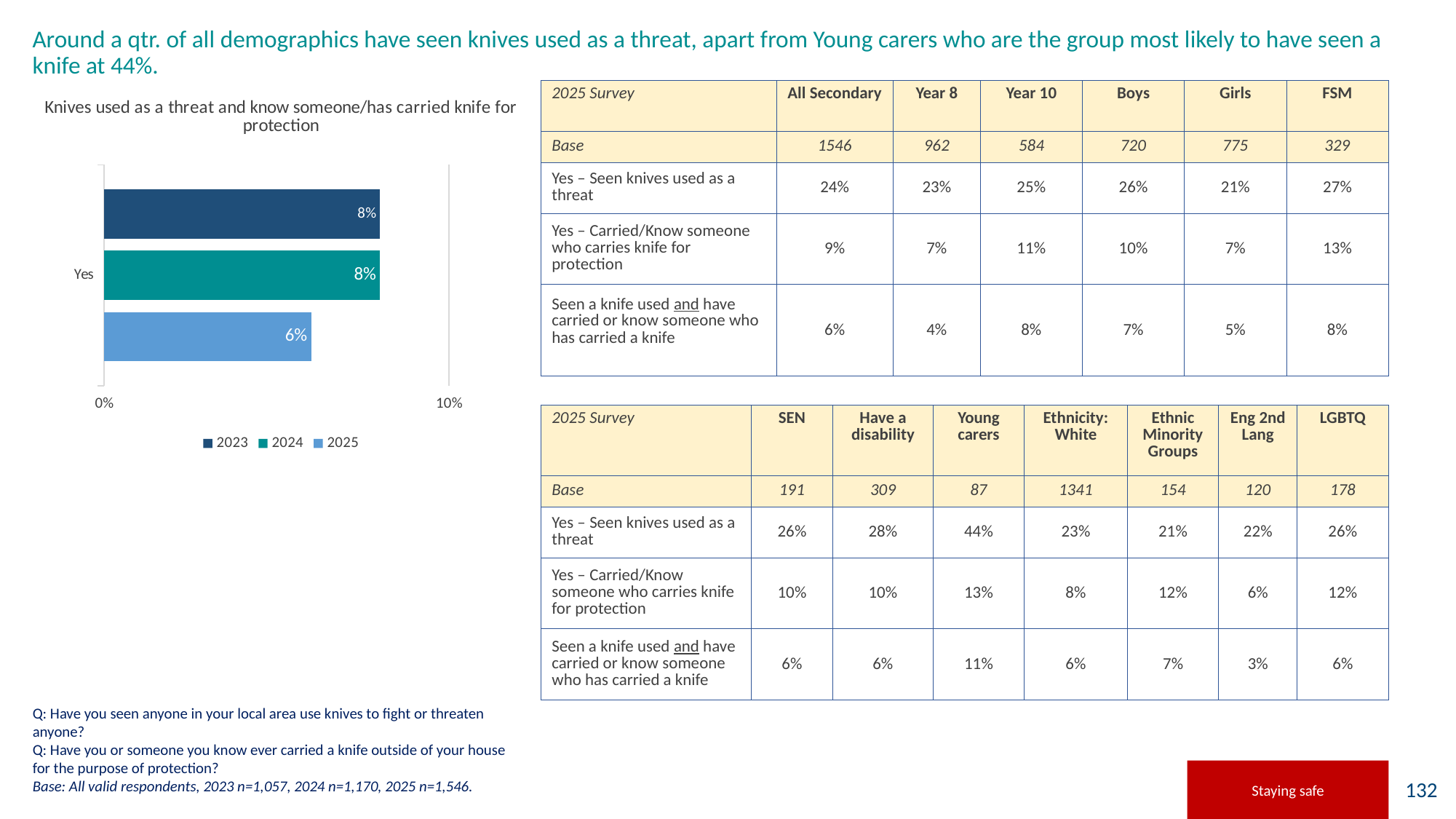
What is the difference between the 2024 value and the 2025 value in the chart? 2% What is the maximum value shown on the chart's horizontal axis? 10% How many series does the chart's legend list? 3 Which is larger in the chart, the value for 2023 or the value for 2025? 2023 What is the value for 2023 in the chart? 8% How many categories are shown on the chart's vertical axis? 1 Which year has the lowest value in the chart? 2025 What is the value for 2025 in the chart? 6% What is the title of the chart? Knives used as a threat and know someone/has carried knife for protection What kind of chart is shown on the slide? bar chart Is the value for 2025 in the chart greater or less than 10%? less What is the value for 2024 in the chart? 8%